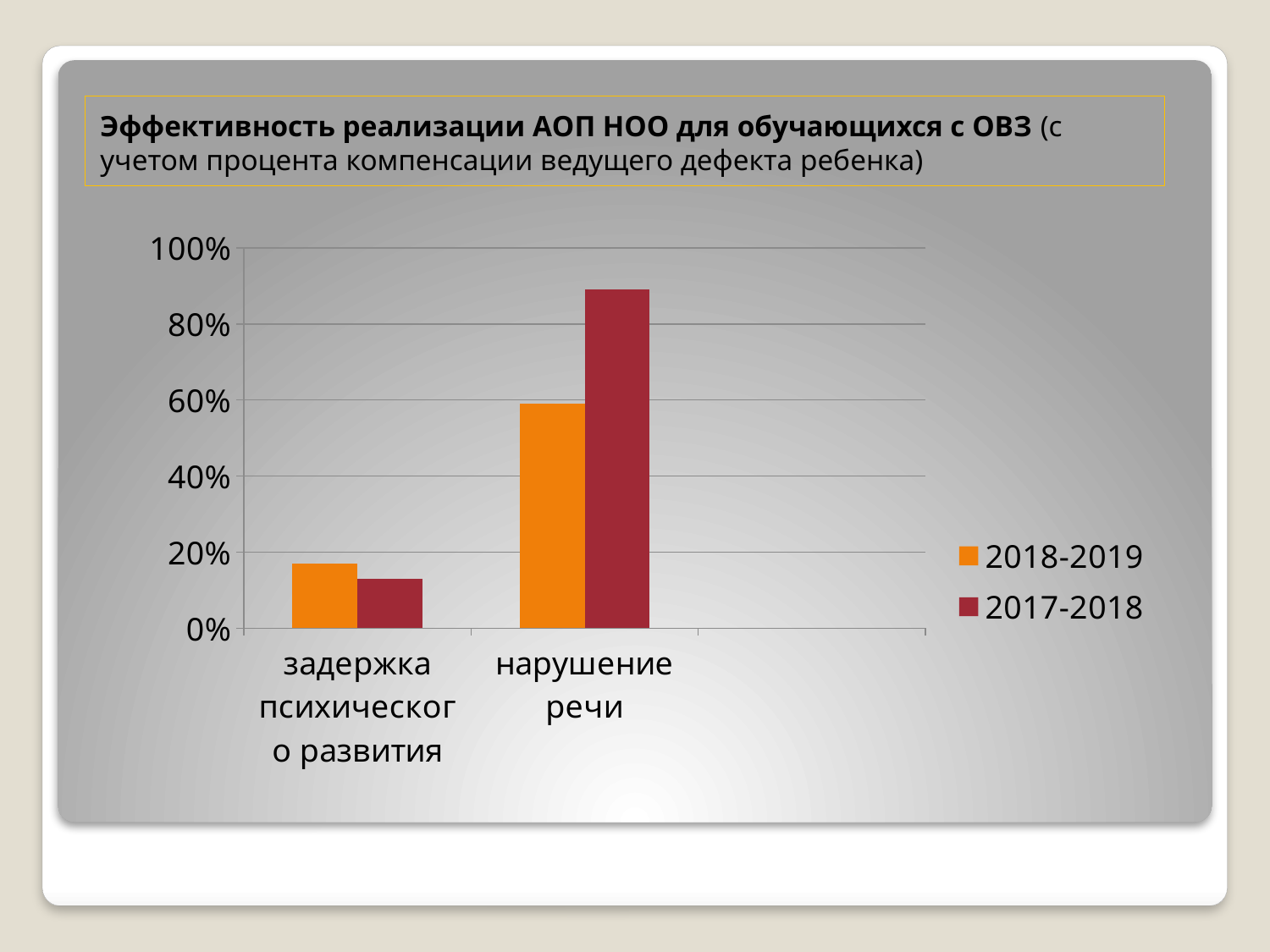
Which category has the lowest bar for the 2018-2019 series? задержка психического развития Which series does the legend list first? 2018-2019 For нарушение речи, which series has the larger value, 2018-2019 or 2017-2018? 2017-2018 How many series does the legend list? 2 For задержка психического развития, which series has the larger value, 2018-2019 or 2017-2018? 2018-2019 How many categories are shown on the x axis? 2 What kind of chart is shown on the slide? bar chart Is the 2017-2018 value for задержка психического развития greater or less than 20%? less Is the 2017-2018 value for нарушение речи greater or less than 80%? greater Is the 2018-2019 value for нарушение речи greater or less than 80%? less Which category has the highest bar for the 2017-2018 series? нарушение речи